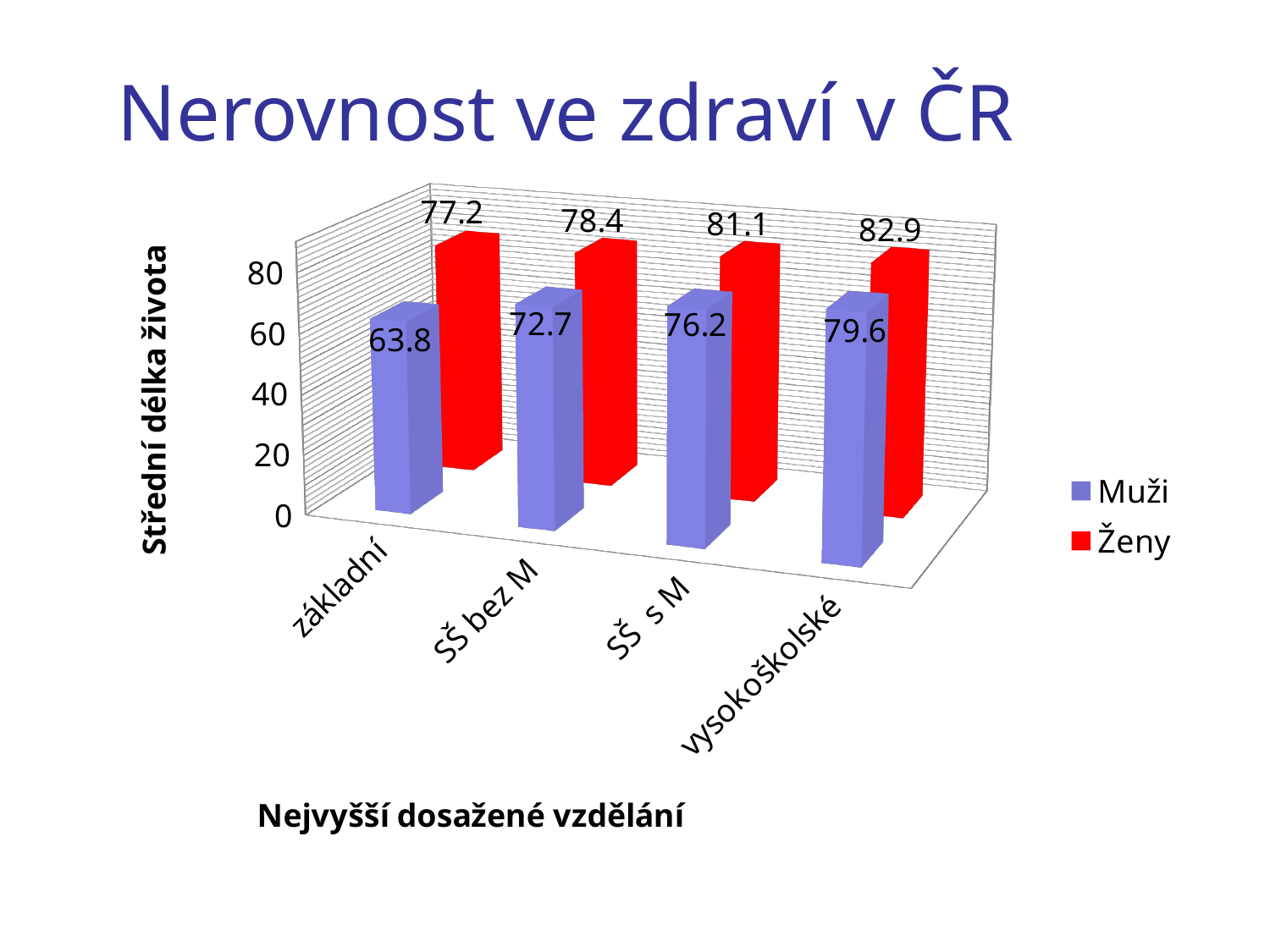
How many series does the legend list? 2 What is the value for Muži in the základní category? 63.8 How many education categories are shown on the x axis? 4 What is the value for Ženy in the vysokoškolské category? 82.9 What is the difference between Ženy and Muži in the základní category? 13.4 What kind of chart is shown on the slide? bar chart What is the value for Muži in the SŠ s M category? 76.2 What is the value for Ženy in the SŠ bez M category? 78.4 Do the Muži values rise or fall from základní to vysokoškolské? rise Which category has the highest value for Muži? vysokoškolské Which is larger: Muži in vysokoškolské or Ženy in SŠ bez M? Muži in vysokoškolské Which category has the lowest value for Ženy? základní